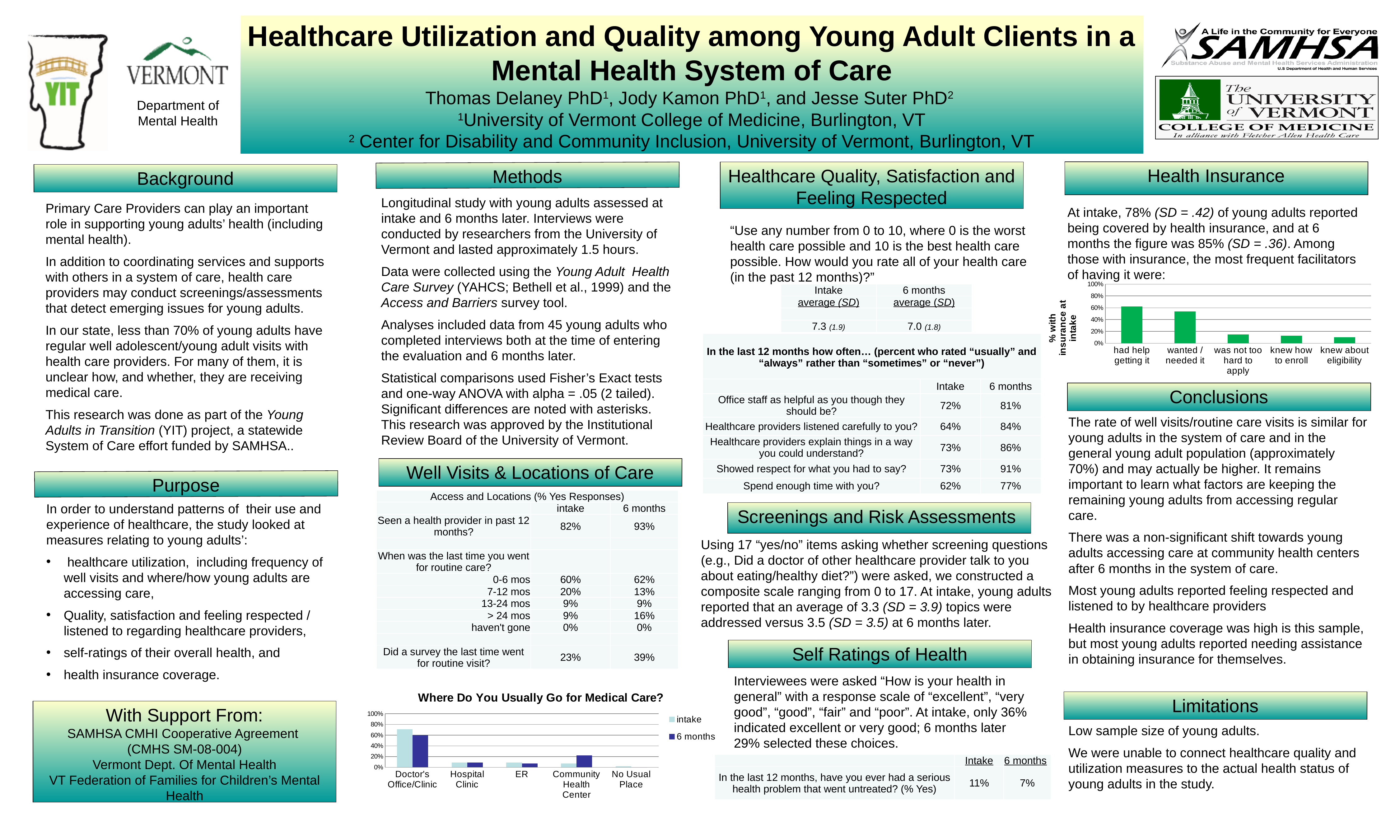
In the "Where Do You Usually Go for Medical Care?" chart, which is larger for Doctor's Office/Clinic: intake or 6 months? intake In the "Where Do You Usually Go for Medical Care?" chart, is the 6 months value for Community Health Center greater or less than 40%? less In the "Where Do You Usually Go for Medical Care?" chart, which category has the highest intake value? Doctor's Office/Clinic In the Health Insurance chart (top right), is the value for "had help getting it" greater or less than 40%? greater In the "Where Do You Usually Go for Medical Care?" chart, is the intake value for Doctor's Office/Clinic greater or less than 60%? greater How many categories are shown in the Health Insurance chart (top right, "% with insurance at intake")? 5 What are the two legend entries in the "Where Do You Usually Go for Medical Care?" chart? intake and 6 months How many categories are shown on the x axis of the "Where Do You Usually Go for Medical Care?" chart? 5 In the Health Insurance chart (top right), which category has the highest value? had help getting it How many series does the legend of the "Where Do You Usually Go for Medical Care?" chart list? 2 In the "Where Do You Usually Go for Medical Care?" chart, which is larger for Community Health Center: intake or 6 months? 6 months What kind of chart is the "Where Do You Usually Go for Medical Care?" chart? bar chart